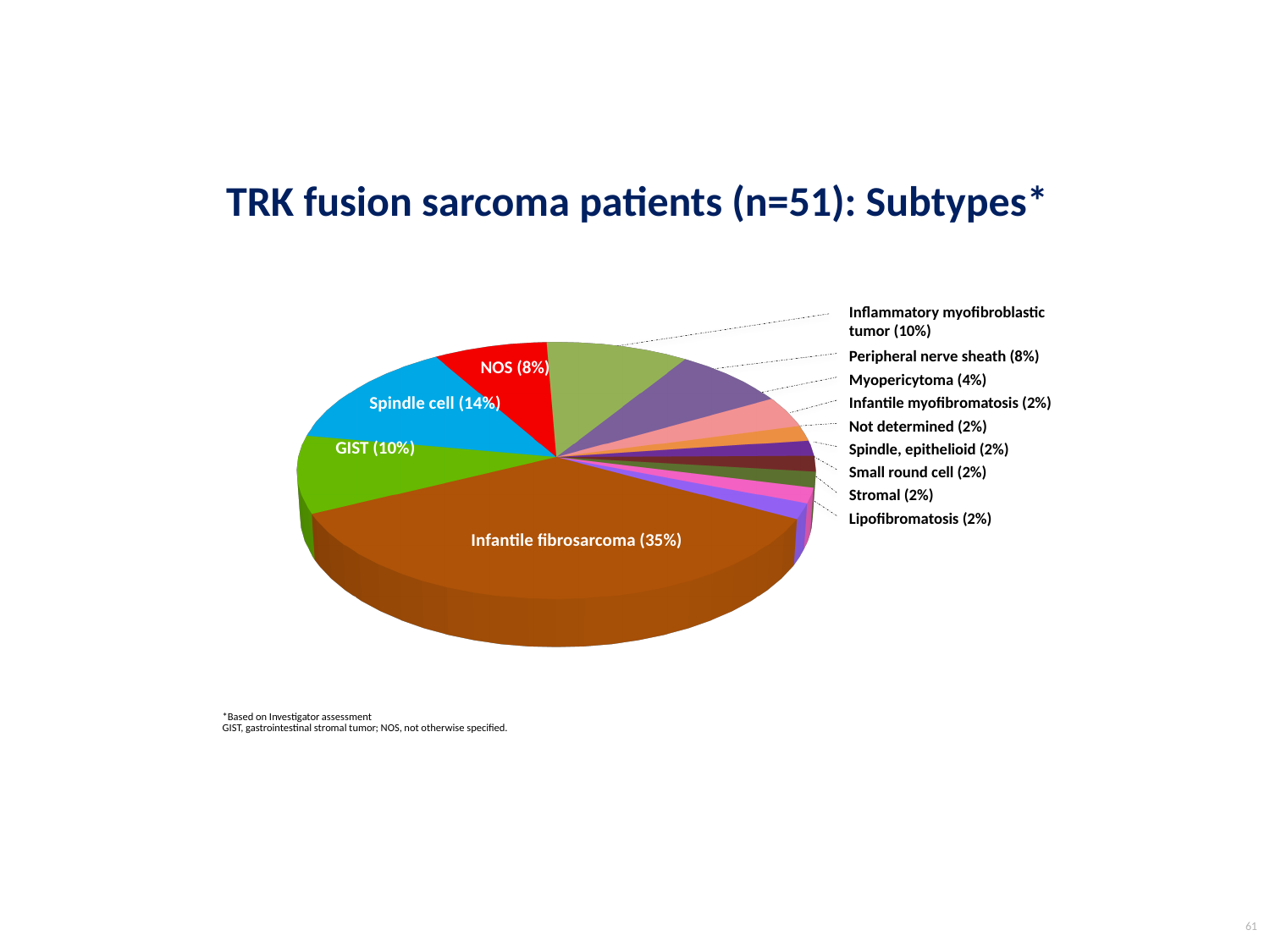
Which subtype has the largest share of the pie? Infantile fibrosarcoma What is the title of the chart? TRK fusion sarcoma patients (n=51): Subtypes* What is the difference in percentage points between Peripheral nerve sheath and Myopericytoma? 4 What percentage is shown for Lipofibromatosis? 2% What percentage is shown for Inflammatory myofibroblastic tumor? 10% What percentage is shown for Spindle cell? 14% What kind of chart is shown on the slide? Pie chart What is the difference in percentage points between Infantile fibrosarcoma and Spindle cell? 21 How many subtype categories are shown in the pie chart? 13 What share of the pie is Infantile fibrosarcoma? 35% What percentage is shown for Myopericytoma? 4% Which is larger, the share for GIST or the share for NOS? GIST